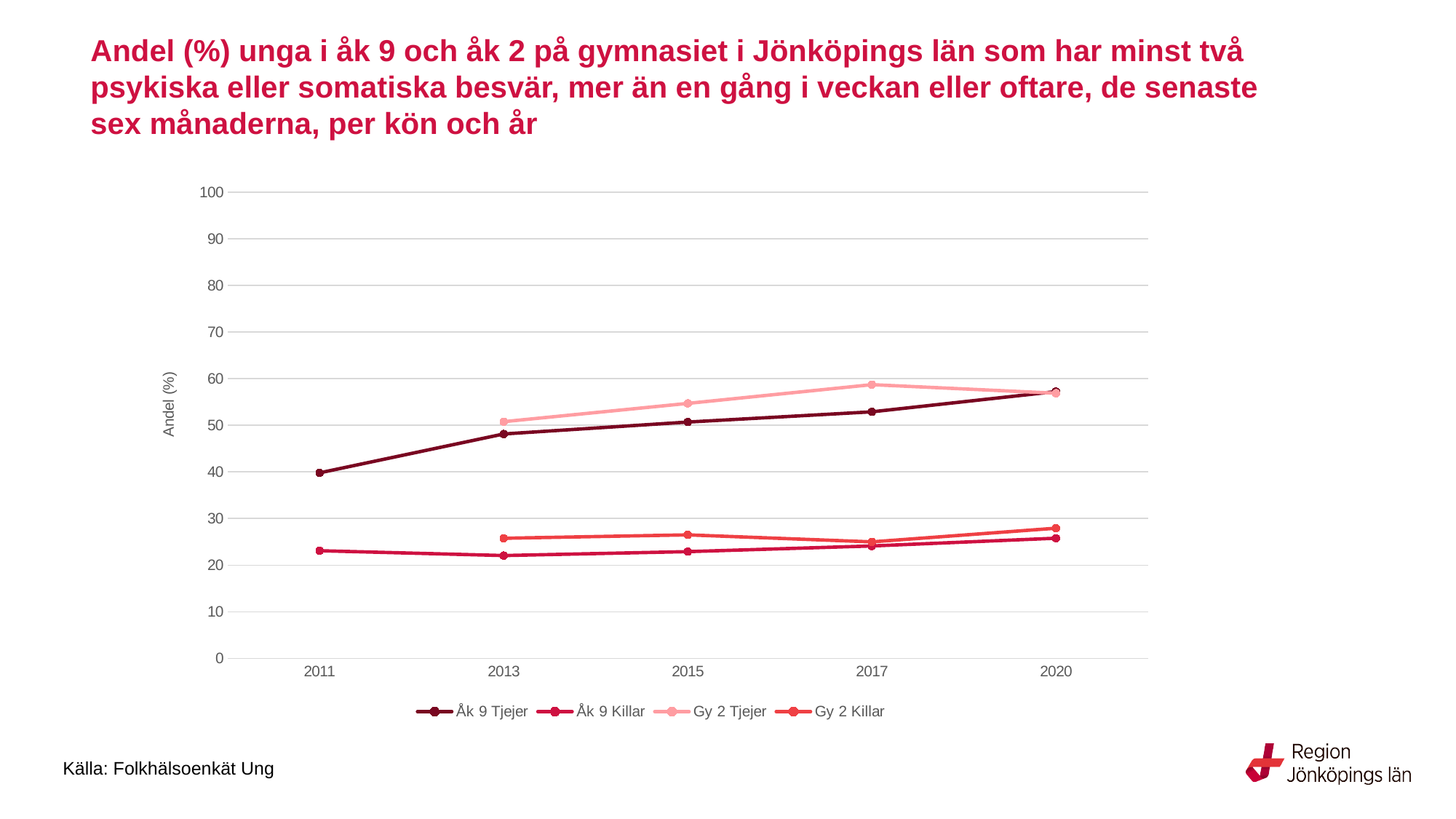
For Åk 9 Tjejer, is the value larger in 2011 or in 2013? 2013 How many years are shown on the x axis? 5 What is the label on the y axis? Andel (%) What kind of chart is shown on the slide? line chart Which series has the highest value in 2017? Gy 2 Tjejer How many series does the legend list? 4 Is the value for Åk 9 Killar in 2013 greater or less than 30? less Does the value for Åk 9 Tjejer rise or fall from 2011 to 2020? rise Is the value for Åk 9 Tjejer in 2011 greater or less than 50? less Which series has the lowest value in 2013? Åk 9 Killar Is the value for Gy 2 Tjejer in 2017 greater or less than 50? greater How many series have a data point plotted for 2011? 2